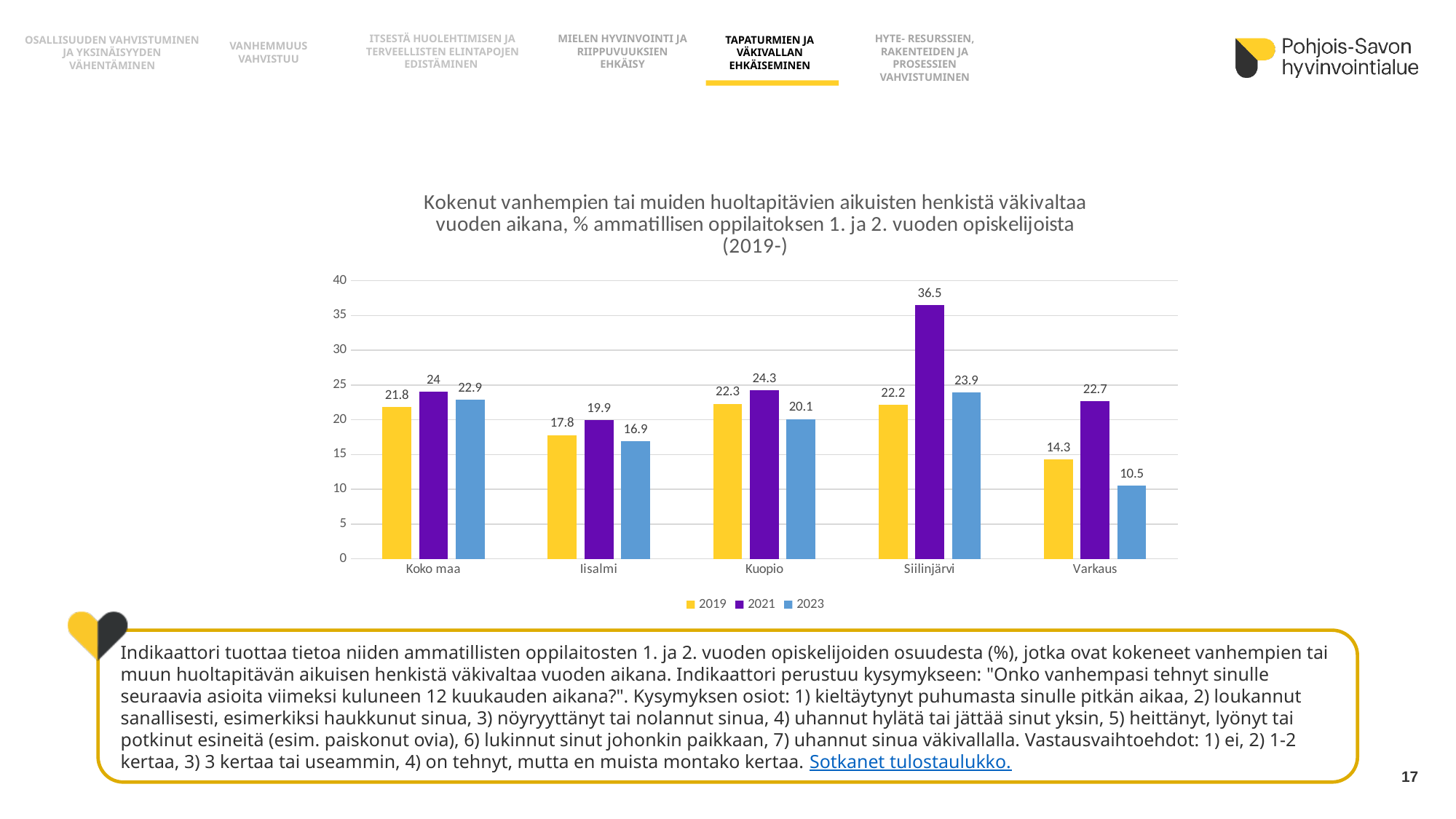
What kind of chart is shown on the slide? Bar chart Which category has the highest value in the 2021 series? Siilinjärvi What is the value for Siilinjärvi in 2021? 36.5 What is the value for Varkaus in 2023? 10.5 Which category has the lowest value in the 2023 series? Varkaus Which is larger for Kuopio: the 2019 value or the 2023 value? 2019 Which colour represents the 2021 series in the chart? Purple How many series does the legend list? 3 What is the difference between the 2019 and 2021 values for Varkaus? 8.4 How many categories are shown on the x axis? 5 What is the value for Koko maa in 2019? 21.8 What is the difference between the 2021 and 2023 values for Siilinjärvi? 12.6